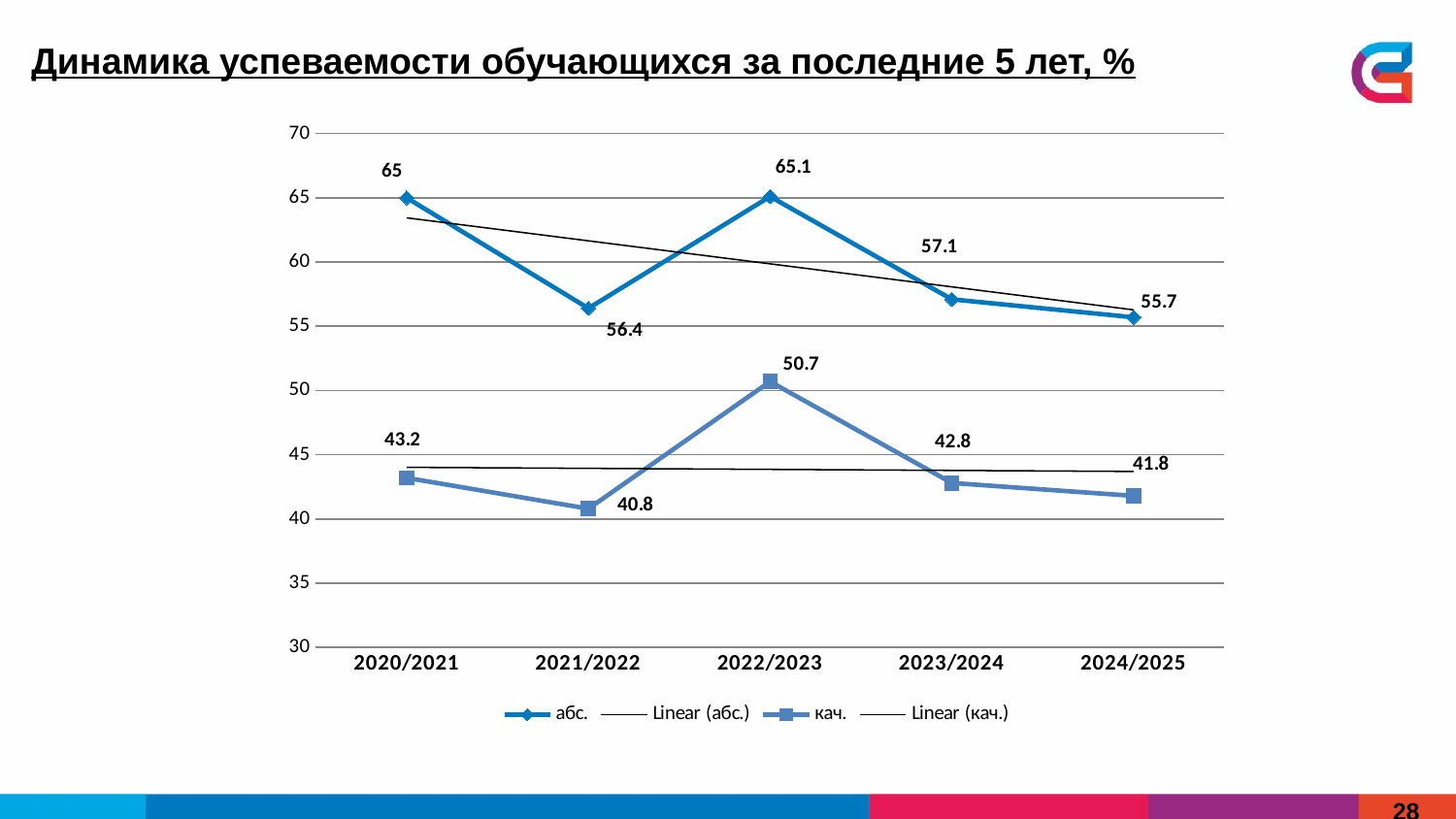
How many academic years are shown on the x axis? 5 Does the абс. series rise or fall from 2022/2023 to 2024/2025? fall What is the difference between the абс. value and the кач. value for 2020/2021? 21.8 In which academic year is the кач. series highest? 2022/2023 What kind of chart is shown on the slide? line chart Which is larger: the кач. value for 2023/2024 or the кач. value for 2024/2025? 2023/2024 In which academic year is the абс. series lowest? 2024/2025 What is the value of the кач. series for 2021/2022? 40.8 What is the title of the chart? Динамика успеваемости обучающихся за последние 5 лет, % What is the value of the абс. series for 2024/2025? 55.7 What is the value of the абс. series for 2022/2023? 65.1 How many entries does the legend list? 4